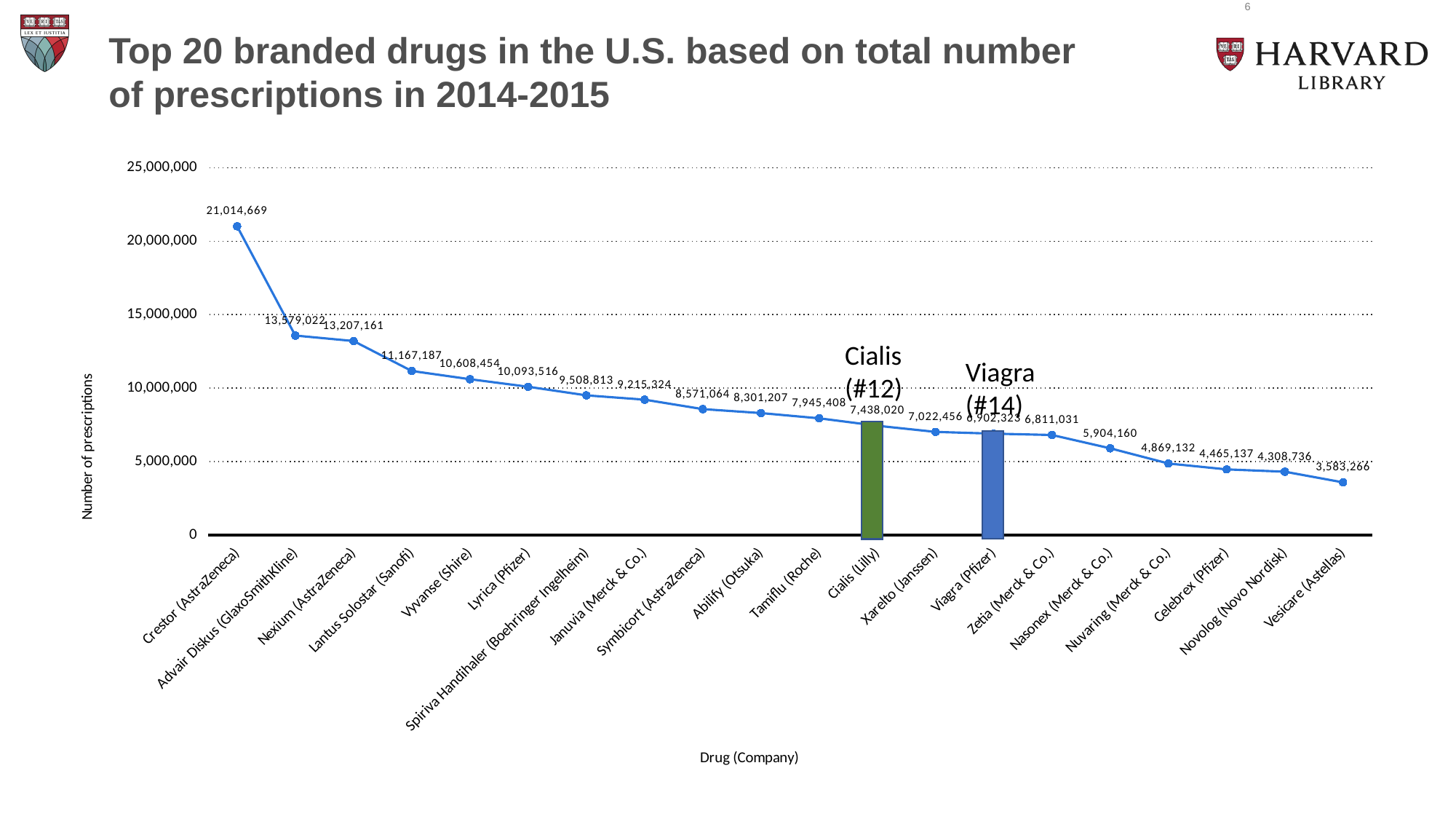
How many drugs are plotted on the chart? 20 Is the value for Nuvaring (Merck & Co.) greater or less than 5,000,000? less What kind of chart is shown on the slide? line chart Which drug has the highest number of prescriptions? Crestor (AstraZeneca) Which has more prescriptions, Lyrica (Pfizer) or Tamiflu (Roche)? Lyrica (Pfizer) Do the values rise or fall moving from left to right along the x axis? fall What is the number of prescriptions for Nasonex (Merck & Co.)? 5,904,160 Which drug has the lowest number of prescriptions? Vesicare (Astellas) What is the number of prescriptions for Crestor (AstraZeneca)? 21,014,669 What is the difference in prescriptions between Crestor (AstraZeneca) and Advair Diskus (GlaxoSmithKline)? 7,435,647 What is the number of prescriptions for Cialis (Lilly)? 7,438,020 What is the label of the y axis? Number of prescriptions